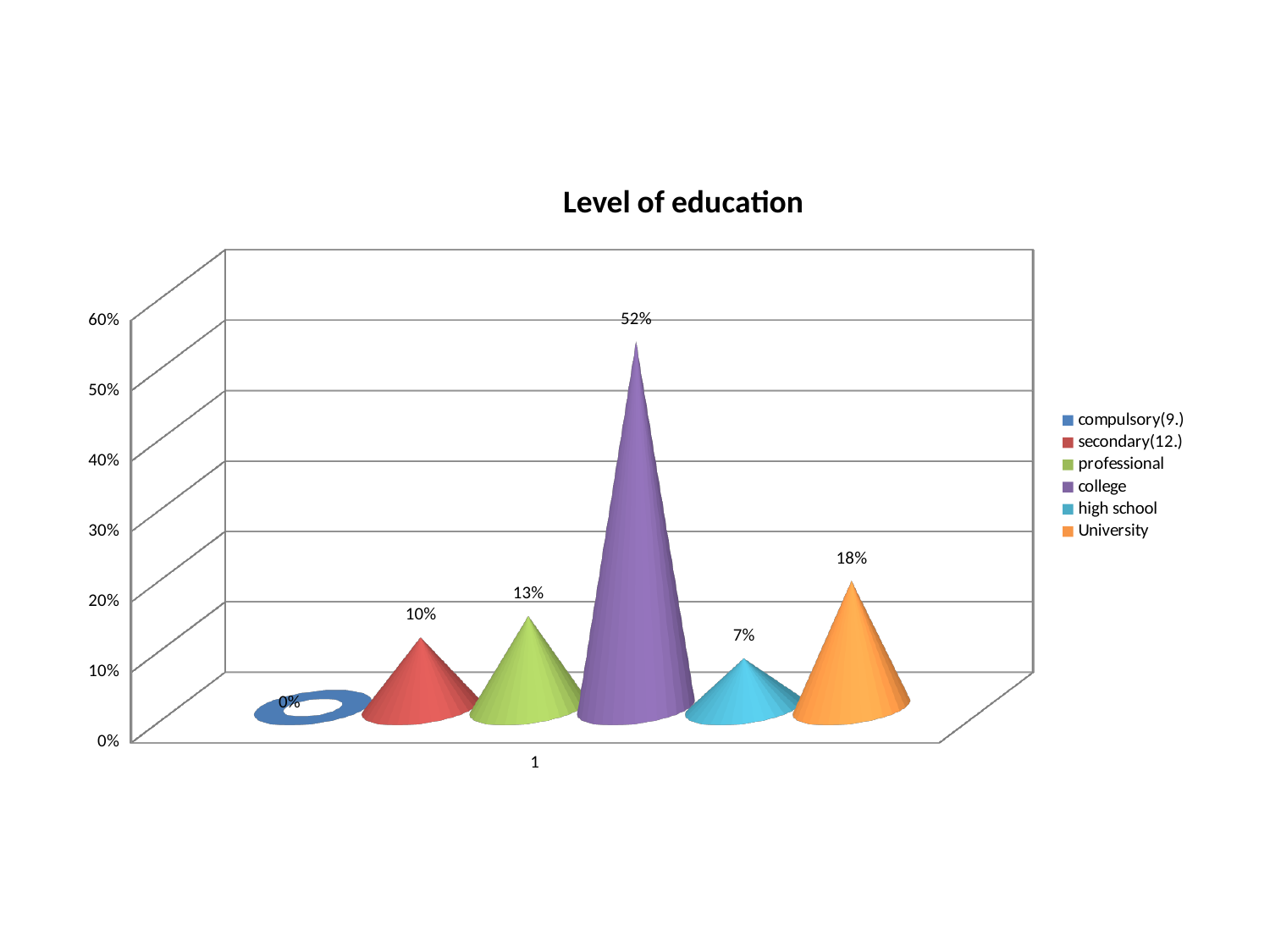
What is the title of the chart? Level of education How many series does the legend list? 6 What is the value for secondary(12.)? 10% What kind of chart is shown? bar chart What is the difference between the values for college and University? 34% Which series has the highest value? college What is the value for high school? 7% What is the value for college? 52% Which is larger, the value for professional or the value for secondary(12.)? professional What is the value for University? 18% What is the difference between the values for professional and high school? 6% Which series has the lowest value? compulsory(9.)